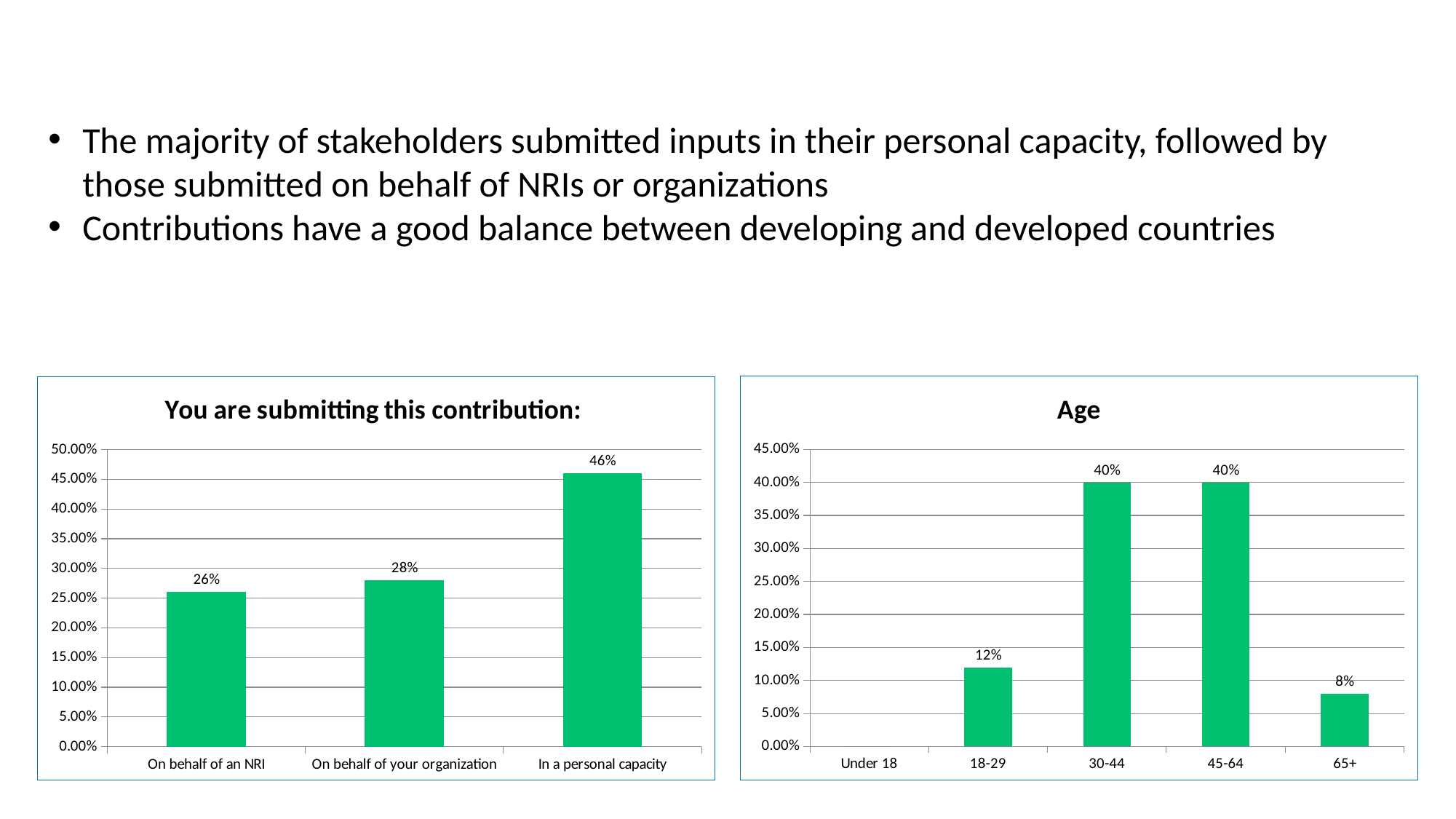
In the 'Age' chart, how many age categories are listed on the x axis? 5 In the 'You are submitting this contribution:' chart, what is the difference between 'In a personal capacity' and 'On behalf of your organization'? 18% In the 'Age' chart, what is the difference between the values for '30-44' and '18-29'? 28% In the 'You are submitting this contribution:' chart, what is the value for 'In a personal capacity'? 46% In the 'You are submitting this contribution:' chart, which category has the lowest value? On behalf of an NRI In the 'You are submitting this contribution:' chart, how many categories are shown? 3 What type of chart is the 'Age' chart? Bar chart In the 'Age' chart, what is the value for '65+'? 8% In the 'Age' chart, which age group has the lowest value among those with a visible bar? 65+ In the 'Age' chart, what is the value for '18-29'? 12% In the 'Age' chart, which is larger, the value for '18-29' or the value for '65+'? 18-29 In the 'You are submitting this contribution:' chart, what is the value for 'On behalf of an NRI'? 26%